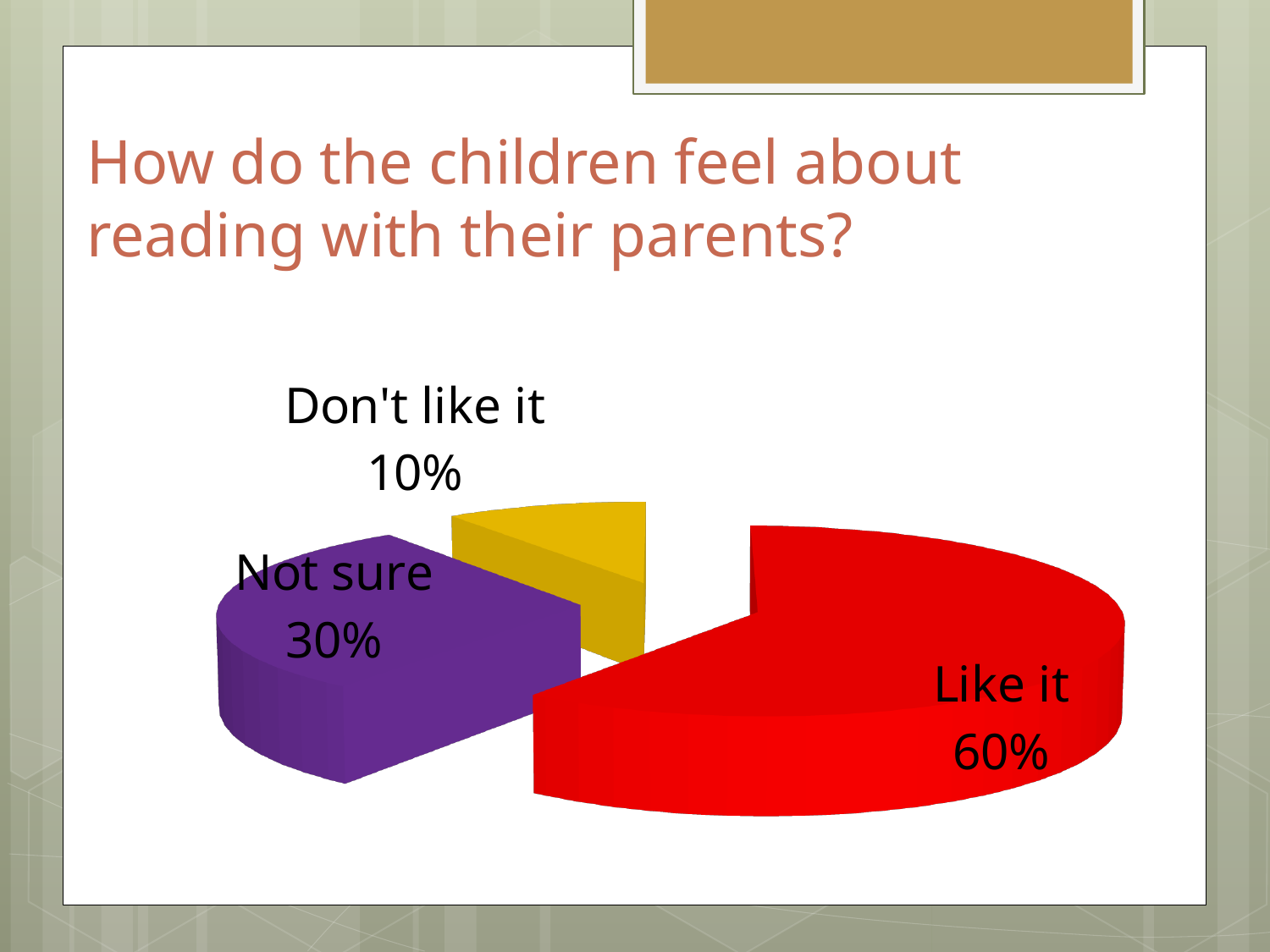
What colour is the "Not sure" slice? Purple Which response has the largest share of the pie? Like it Which response has the smallest share of the pie? Don't like it What percentage of children answered "Like it"? 60% What colour is the "Like it" slice? Red How many slices does the pie chart have? 3 What is the difference in percentage points between "Not sure" and "Don't like it"? 20 Which is larger, the share for "Not sure" or the share for "Don't like it"? Not sure What percentage of children answered "Not sure"? 30% What percentage of children answered "Don't like it"? 10% What kind of chart is shown on the slide? Pie chart What is the difference in percentage points between "Like it" and "Not sure"? 30